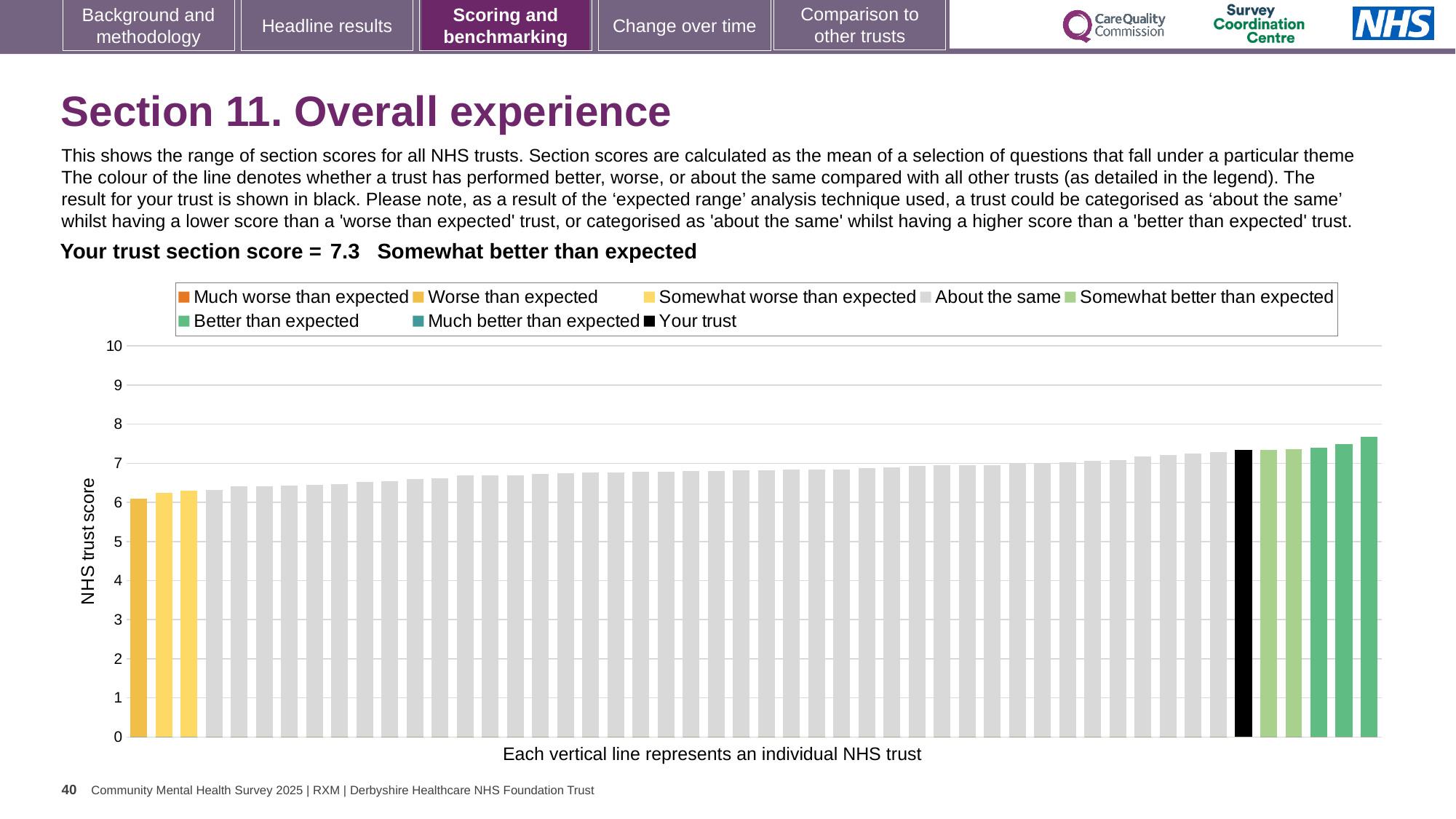
Is the value of the leftmost bar greater or less than 7? less What is the section score for your trust shown on the slide? 7.3 What type of chart is shown on the slide? Bar chart Which bar is higher: the black bar for your trust or the leftmost bar? The black bar for your trust What is the maximum value shown on the y axis? 10 Do the bar values rise or fall moving from left to right along the x axis? Rise Is the value of the rightmost (highest) bar greater or less than 8? less What is the label of the y axis? NHS trust score Is the value of the leftmost bar greater or less than 6? greater How many entries does the chart legend list? 8